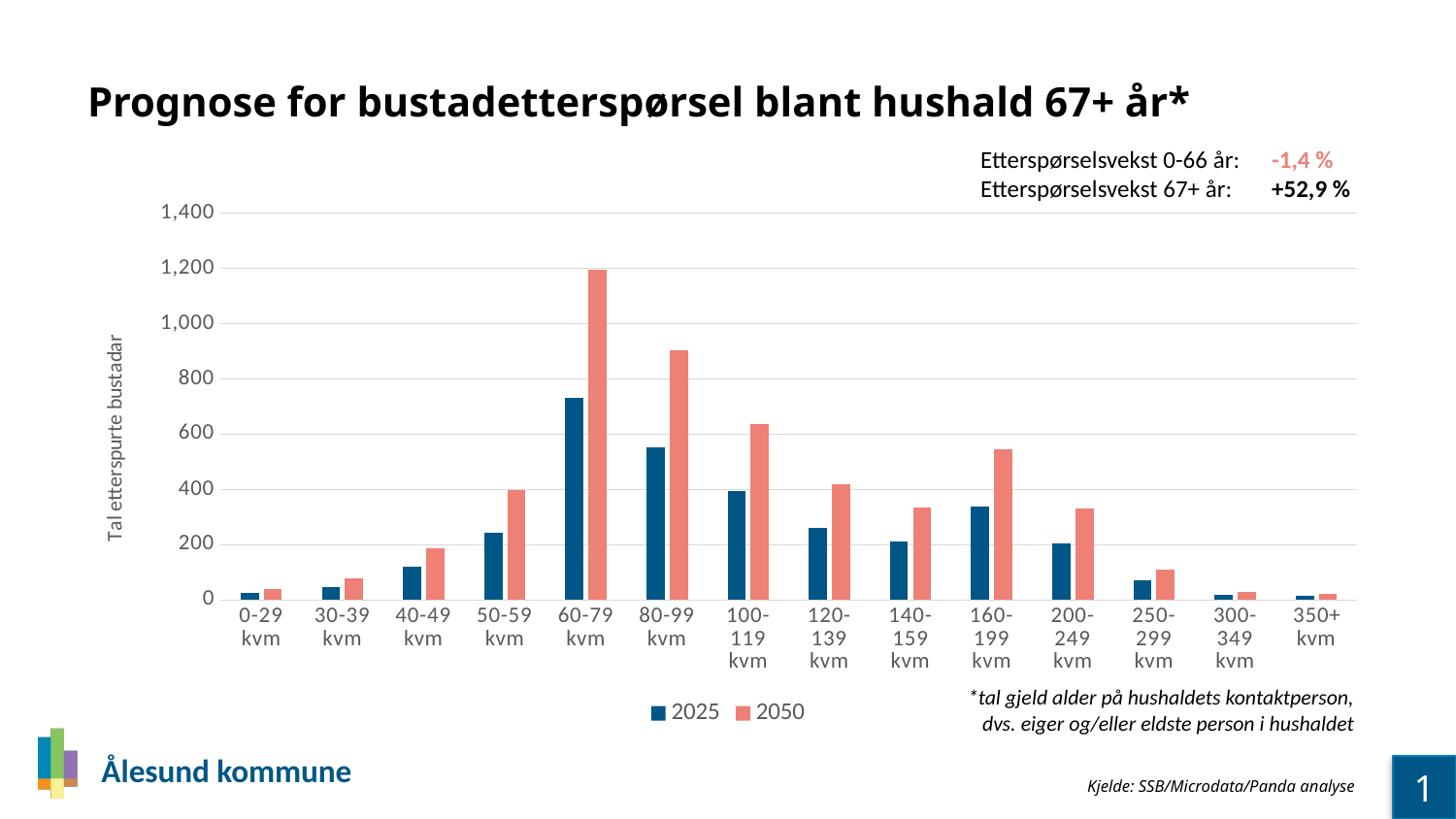
How many size categories (kvm groups) are shown on the x axis? 14 Is the 2025 value for 60-79 kvm greater or less than 800? less For 160-199 kvm, which series has the larger value, 2025 or 2050? 2050 How many series does the legend list? 2 Which size category has the highest value for the 2050 series? 60-79 kvm Is the 2050 value for 60-79 kvm greater or less than 1,000? greater Is the 2025 value for 40-49 kvm greater or less than 200? less Which size category has the highest value for the 2025 series? 60-79 kvm What is the title of the chart on the slide? Prognose for bustadetterspørsel blant hushald 67+ år* What kind of chart is shown on the slide? bar chart For the 2050 series, which is larger: 120-139 kvm or 160-199 kvm? 160-199 kvm